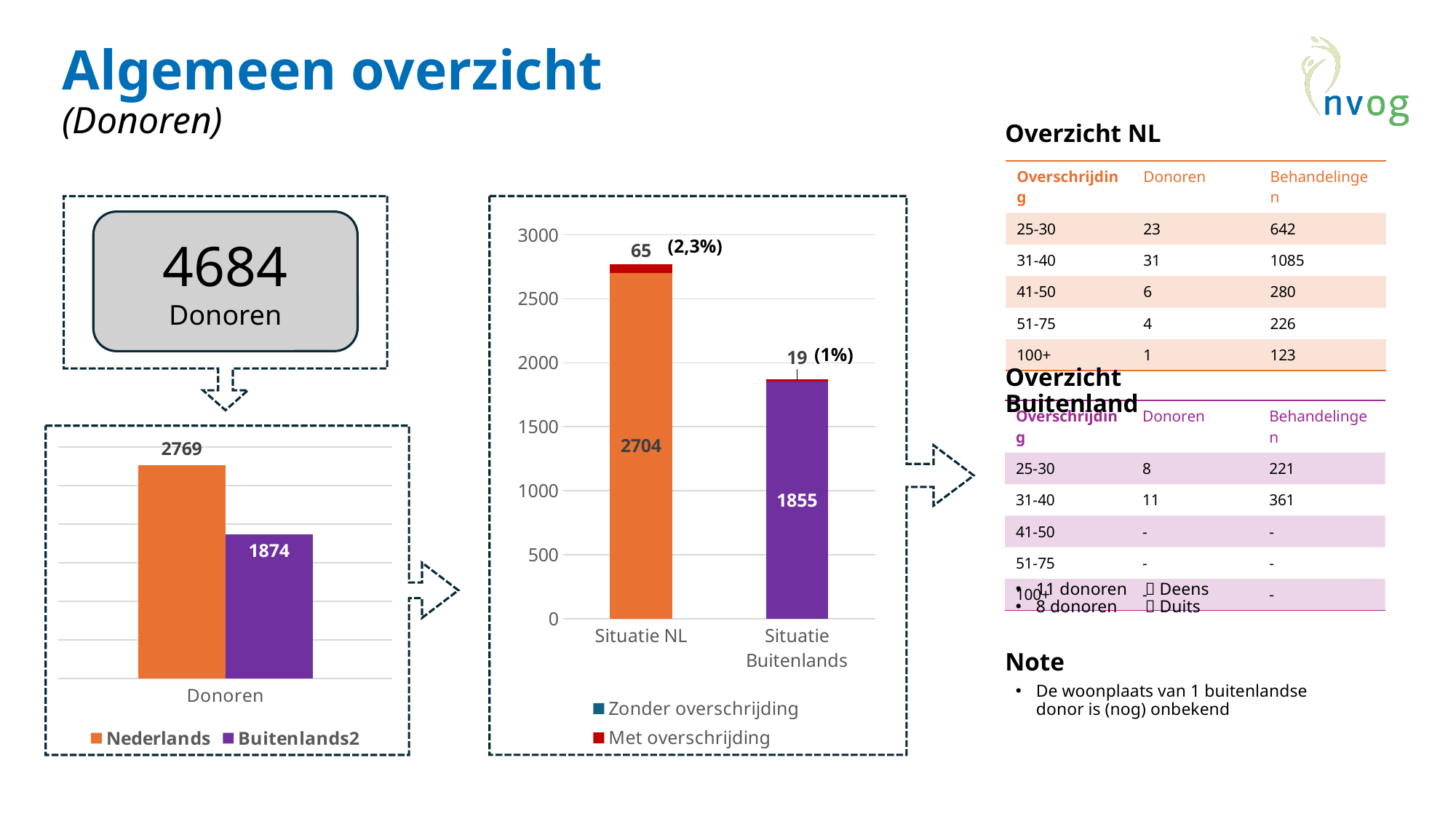
In the left bar chart, which series has the higher value, Nederlands or Buitenlands2? Nederlands What kind of chart is the middle chart? Stacked bar chart In the middle stacked bar chart, what is the Zonder overschrijding value for Situatie NL? 2704 In the middle stacked bar chart, what is the total of the Situatie Buitenlands bar? 1874 In the middle stacked bar chart, what is the Met overschrijding value for Situatie Buitenlands? 19 In the left bar chart, what is the value for Buitenlands2? 1874 In the middle stacked bar chart, what is the total of the Situatie NL bar? 2769 In the middle stacked bar chart, how many categories are shown on the x axis? 2 In the middle stacked bar chart, what percentage is shown next to the Met overschrijding value for Situatie NL? (2,3%) In the left bar chart, how many series does the legend list? 2 In the left bar chart, what is the value for Nederlands? 2769 In the left bar chart, what is the difference between the Nederlands and Buitenlands2 values? 895